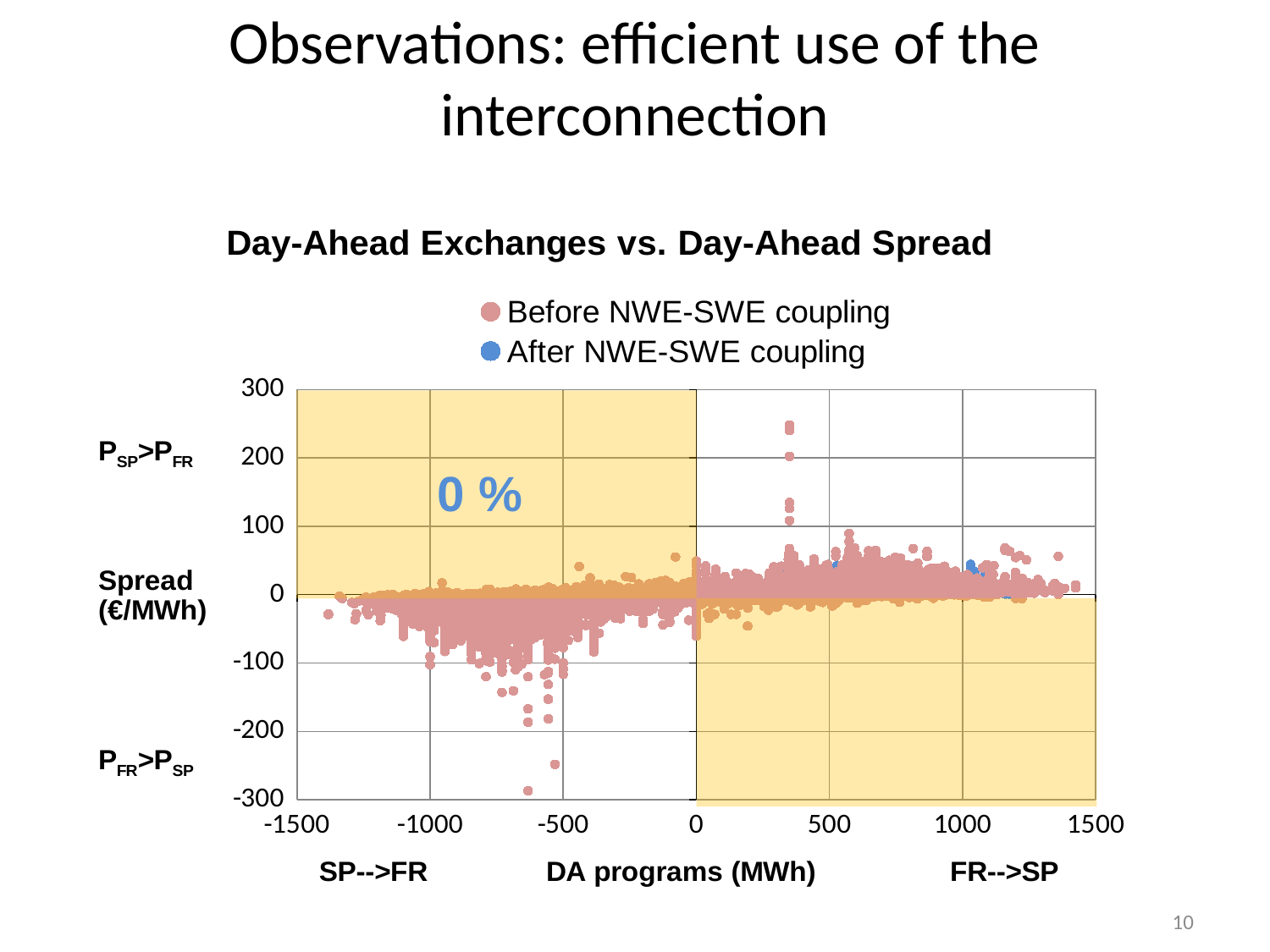
Is the lowest spread value plotted on the chart greater or less than -200? less How many series does the legend list? 2 What percentage is printed in the shaded upper-left region of the chart? 0 % Are the points for the After NWE-SWE coupling series located at positive or negative DA programs values? positive Which series is plotted in blue? After NWE-SWE coupling Is the highest spread value plotted on the chart greater or less than 200? greater What is the title of the chart? Day-Ahead Exchanges vs. Day-Ahead Spread What kind of chart is shown on the slide? scatter chart